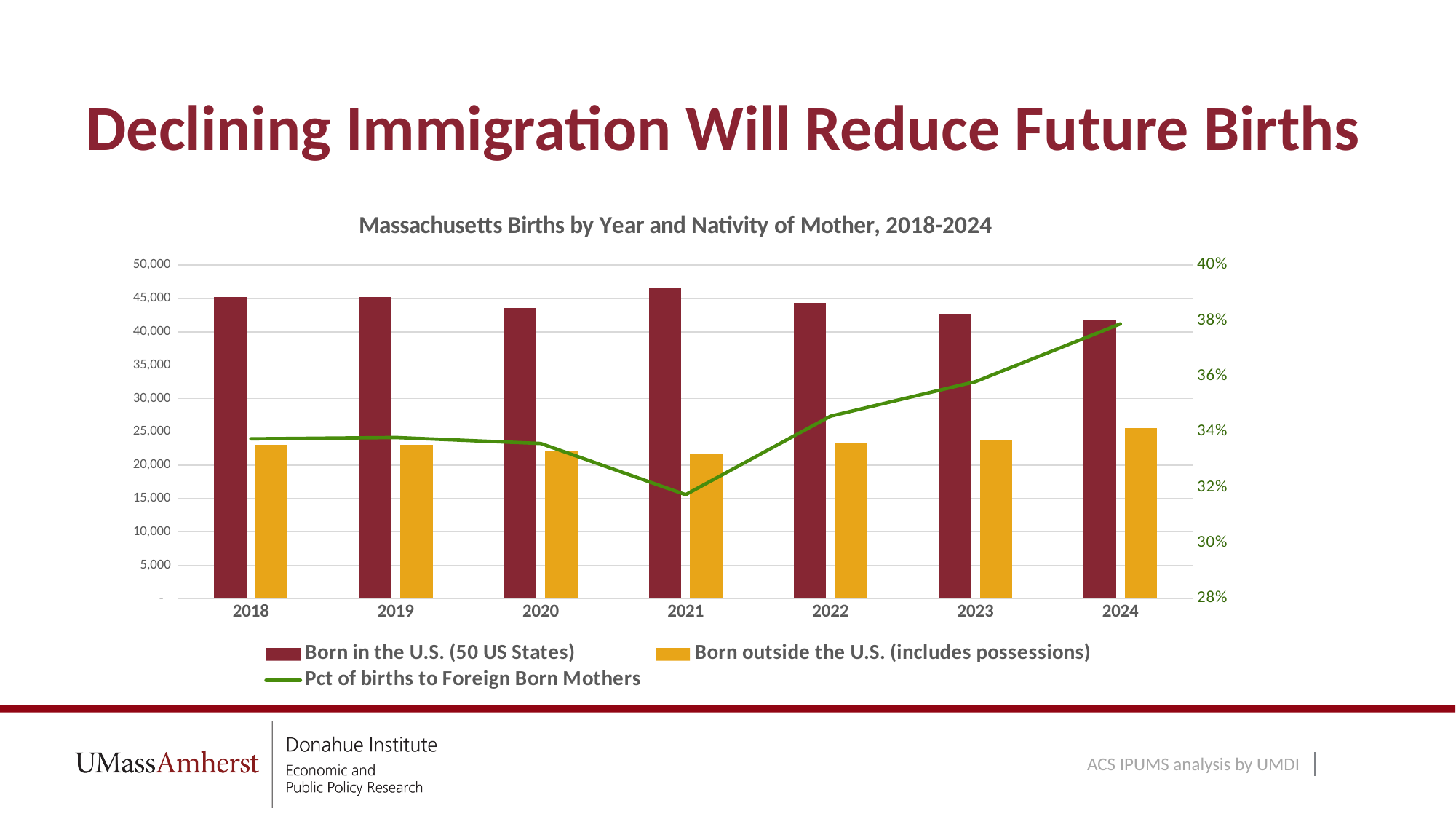
Is the value for 'Born in the U.S. (50 US States)' in 2021 greater or less than 45,000? greater Is the 'Pct of births to Foreign Born Mothers' value in 2021 greater or less than 32%? less How many series does the chart legend list? 3 In which year is the 'Born outside the U.S. (includes possessions)' bar the highest? 2024 Which is larger in 2024: the 'Born in the U.S. (50 US States)' bar or the 'Born outside the U.S. (includes possessions)' bar? Born in the U.S. (50 US States) What is the title of the chart? Massachusetts Births by Year and Nativity of Mother, 2018-2024 Does the 'Pct of births to Foreign Born Mothers' line rise or fall from 2021 to 2024? Rise How many years are shown on the x axis of the chart? 7 What kind of chart is used for the 'Born in the U.S. (50 US States)' series? Bar chart In which year is the 'Born in the U.S. (50 US States)' bar the highest? 2021 In which year is the 'Pct of births to Foreign Born Mothers' line at its lowest point? 2021